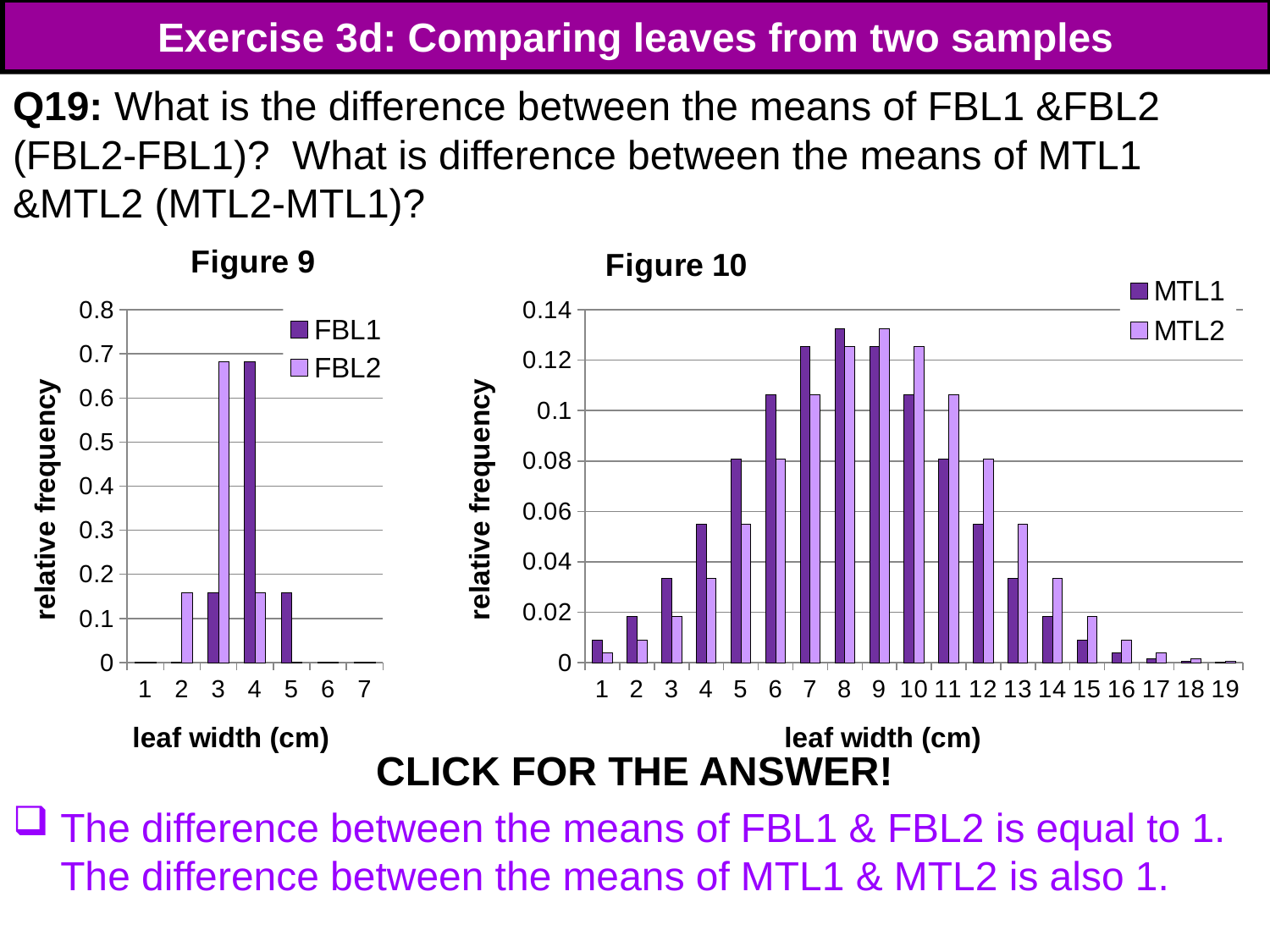
In Figure 9, is the FBL1 value at leaf width 4 greater or less than 0.6? greater In Figure 10, at which leaf width is the MTL2 relative frequency highest? 9 In Figure 9, how many leaf width categories are shown on the x axis? 7 In Figure 9, at which leaf width is the FBL1 relative frequency highest? 4 In Figure 10, how many leaf width categories are shown on the x axis? 19 In Figure 9, at which leaf width is the FBL2 relative frequency highest? 3 In Figure 10, is the MTL1 value at leaf width 1 greater or less than 0.02? less In Figure 9, which series has the larger value at leaf width 4, FBL1 or FBL2? FBL1 In Figure 9, how many series does the legend list? 2 In Figure 9, what kind of chart is shown? bar chart In Figure 10, how many series does the legend list? 2